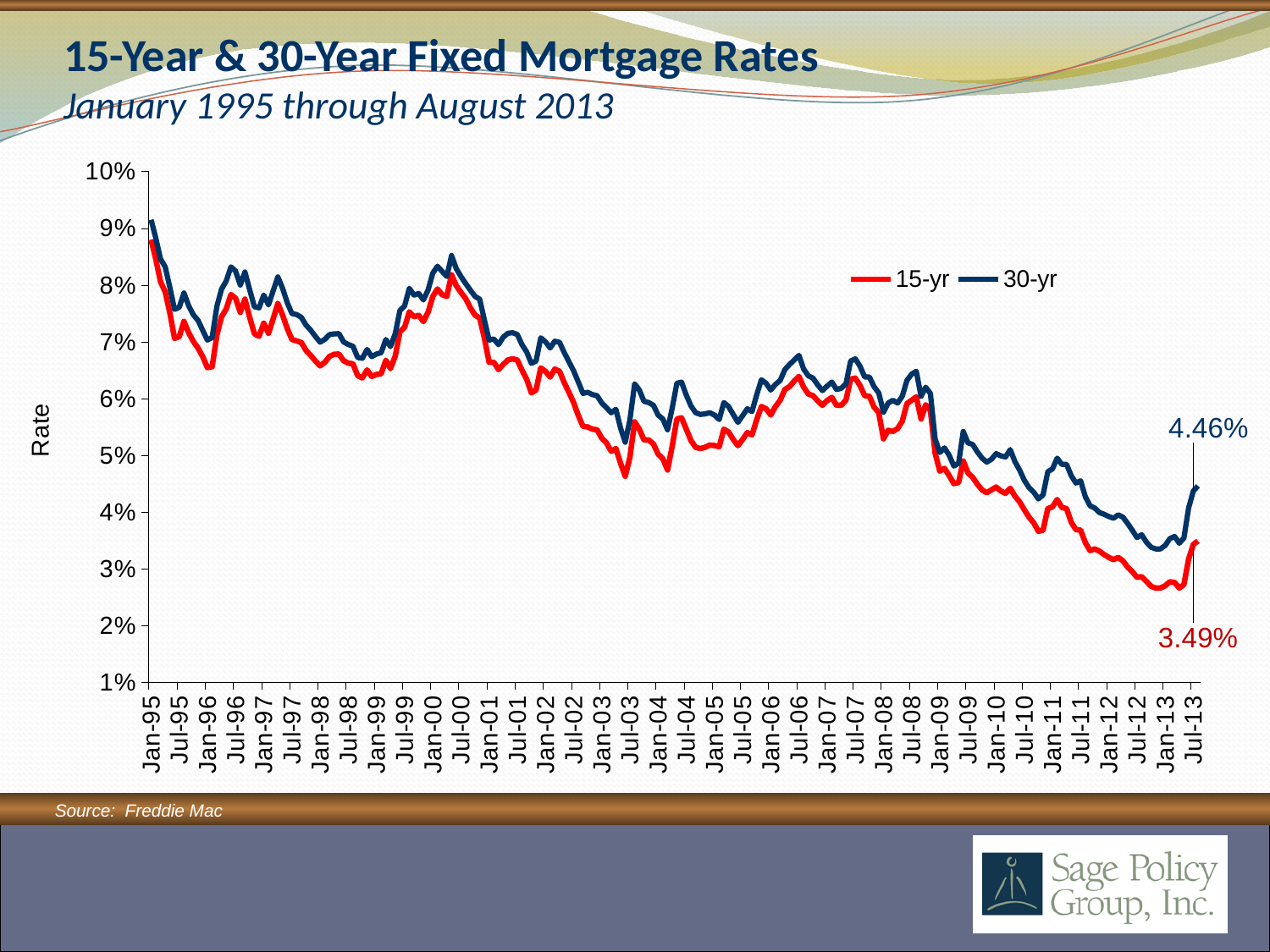
What is the difference between the labelled end values of the 30-yr and 15-yr series? 0.97 percentage points What is the title of the chart on the slide? 15-Year & 30-Year Fixed Mortgage Rates What kind of chart is shown on the slide? Line chart Is the value of the 15-yr series at Jan-95 greater or less than 8%? greater Is the value of the 30-yr series at Jan-13 greater or less than 4%? less What is the labelled value of the 15-yr series at the end of the chart? 3.49% Is the value of the 15-yr series at Jan-13 greater or less than 3%? less How many series does the legend list? 2 What is the labelled value of the 30-yr series at the end of the chart? 4.46% At the end of the chart, which series has the higher labelled value, 15-yr or 30-yr? 30-yr Overall, do the mortgage rates rise or fall from January 1995 to August 2013? Fall Which colour is used for the 30-yr series? Blue